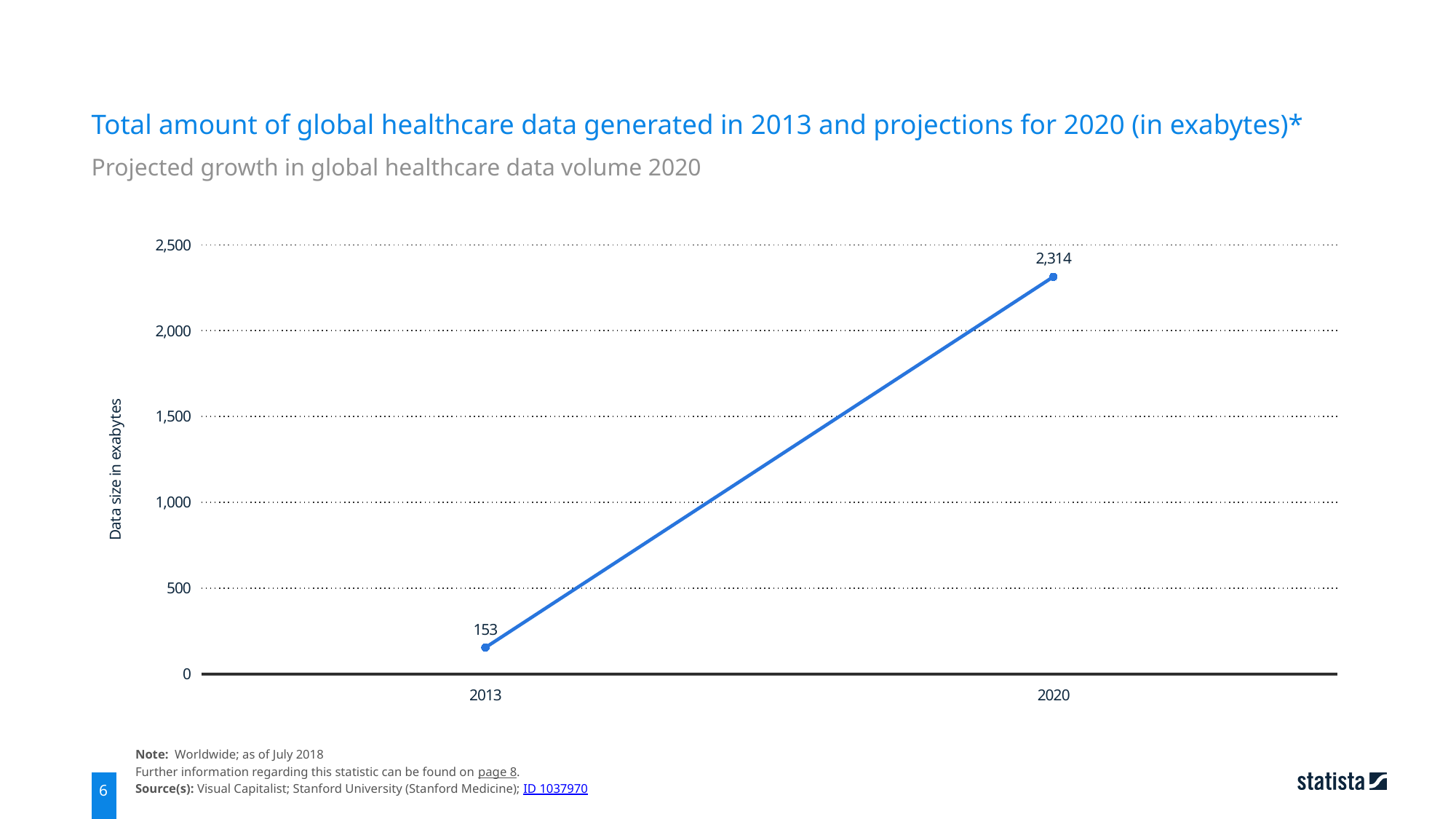
What is the projected value for 2020? 2,314 What is the label of the y axis? Data size in exabytes Which year has the lower value? 2013 Do the values rise or fall from 2013 to 2020? rise What is the highest value shown on the y axis? 2,500 Is the value for 2013 greater or less than 500? less How many data points are plotted on the chart? 2 What kind of chart is shown on the slide? line chart What is the difference between the 2020 and 2013 values? 2,161 Which year has the higher value? 2020 What is the value for 2013? 153 Is the value for 2020 greater or less than 2,000? greater